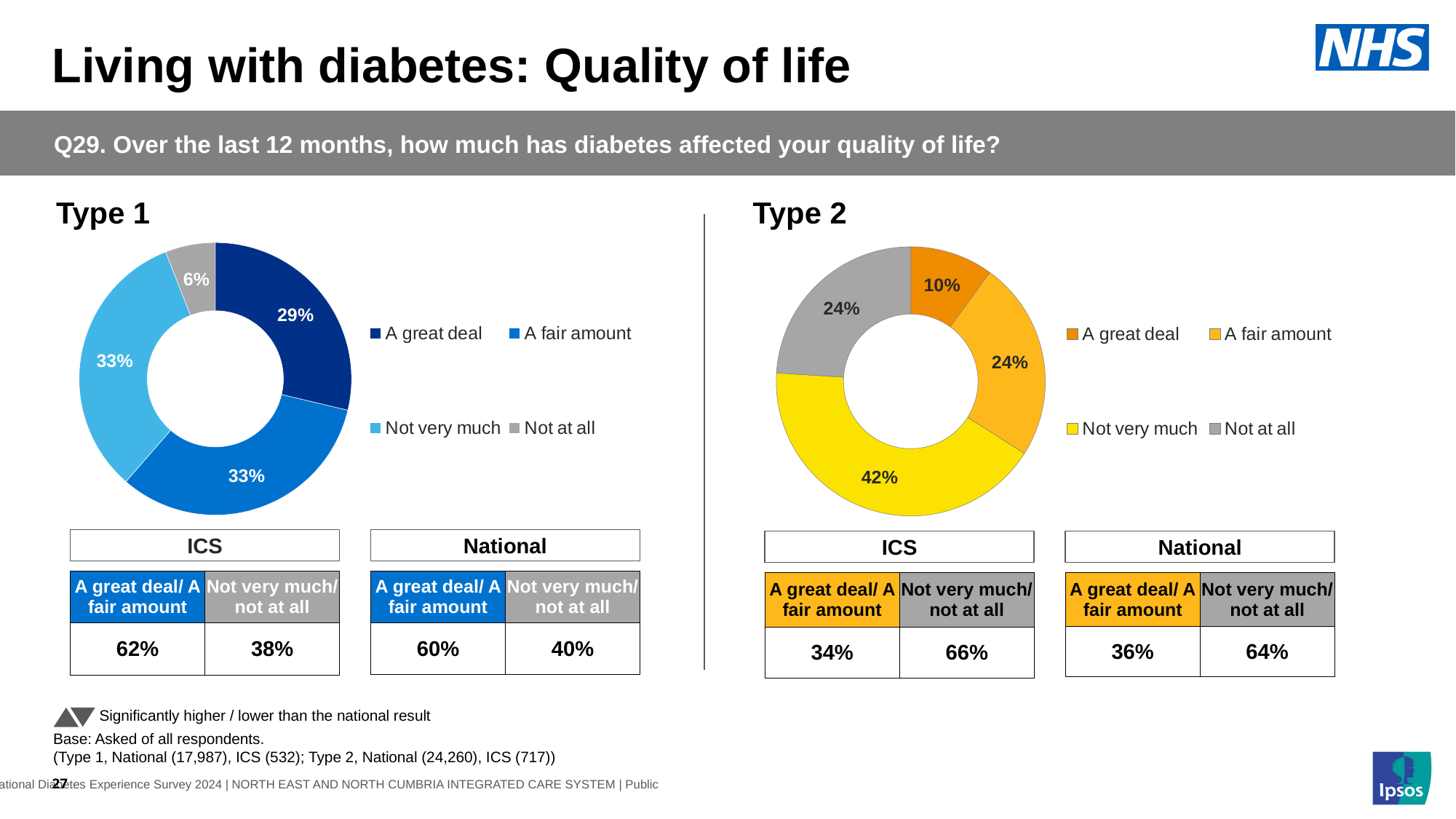
In the Type 1 chart, which is larger: 'A great deal' or 'Not at all'? A great deal In the Type 2 chart, which category has the largest share? Not very much In the Type 2 chart, what is the difference between the 'Not very much' share and the 'A fair amount' share? 18% What kind of chart is used for Type 1? Donut (pie) chart In the Type 1 chart, which category has the smallest share? Not at all In the Type 1 chart, what percentage is shown for 'Not at all'? 6% In the Type 2 chart, what percentage is shown for 'A great deal'? 10% In the Type 2 chart, which category has the smallest share? A great deal In the Type 2 chart, what percentage is shown for 'Not very much'? 42% In the Type 1 chart, what percentage of respondents said diabetes affected their quality of life 'A great deal'? 29% In the Type 2 chart, what colour is the 'Not very much' segment? Yellow How many categories does the legend of the Type 2 chart list? 4